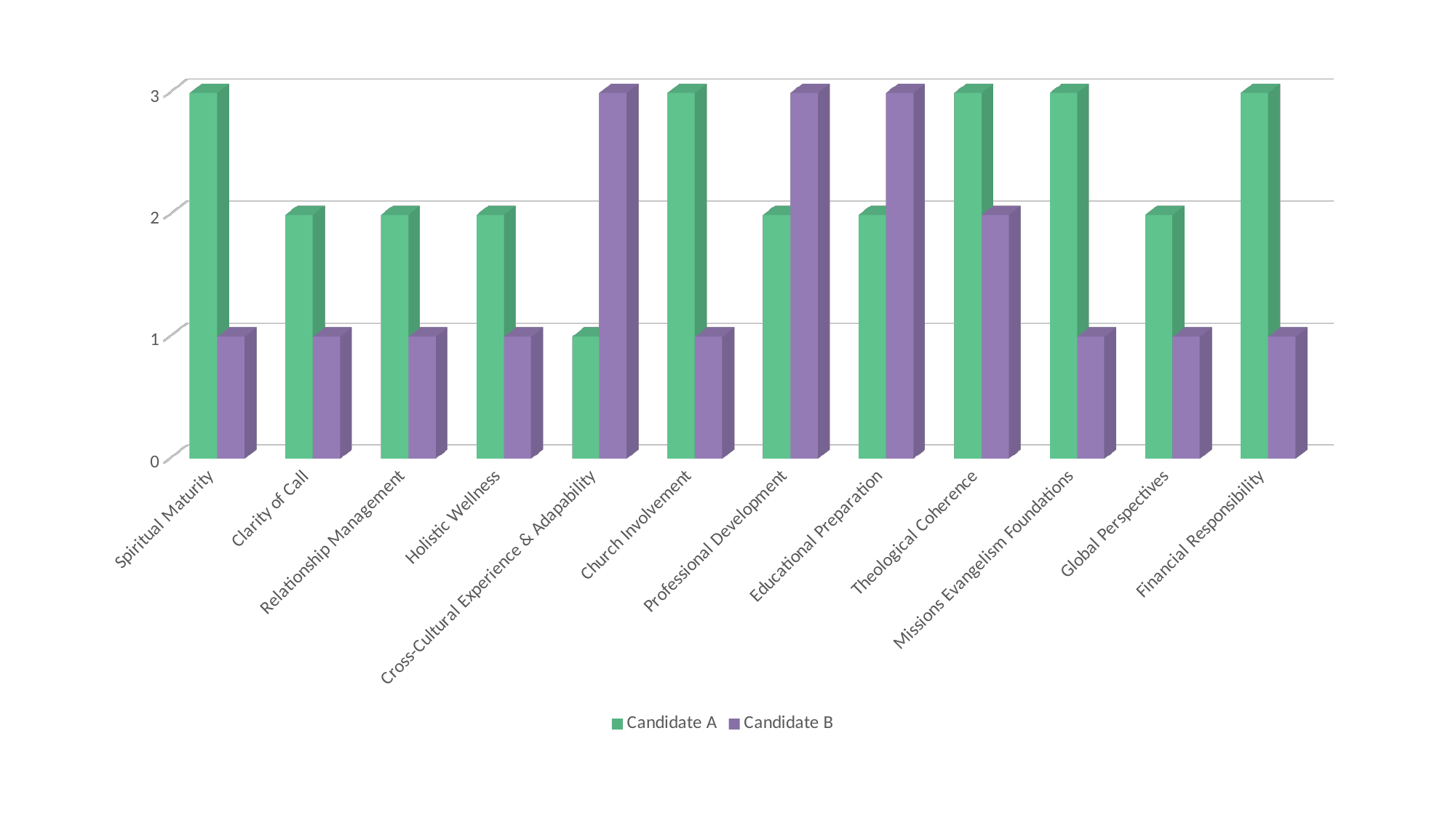
What is the difference between Candidate A and Candidate B in Missions Evangelism Foundations? 2 Which colour represents Candidate B in the chart? Purple How many series does the legend list? 2 What is the value for Candidate B in Cross-Cultural Experience & Adapability? 3 What is the value for Candidate A in Spiritual Maturity? 3 What is the value for Candidate B in Theological Coherence? 2 What is the value for Candidate A in Global Perspectives? 2 Which candidate has the higher value for Church Involvement? Candidate A How many categories are shown on the x axis? 12 Which candidate has the higher value for Educational Preparation? Candidate B What kind of chart is shown on the slide? Bar chart What is the difference between Candidate B and Candidate A in Professional Development? 1